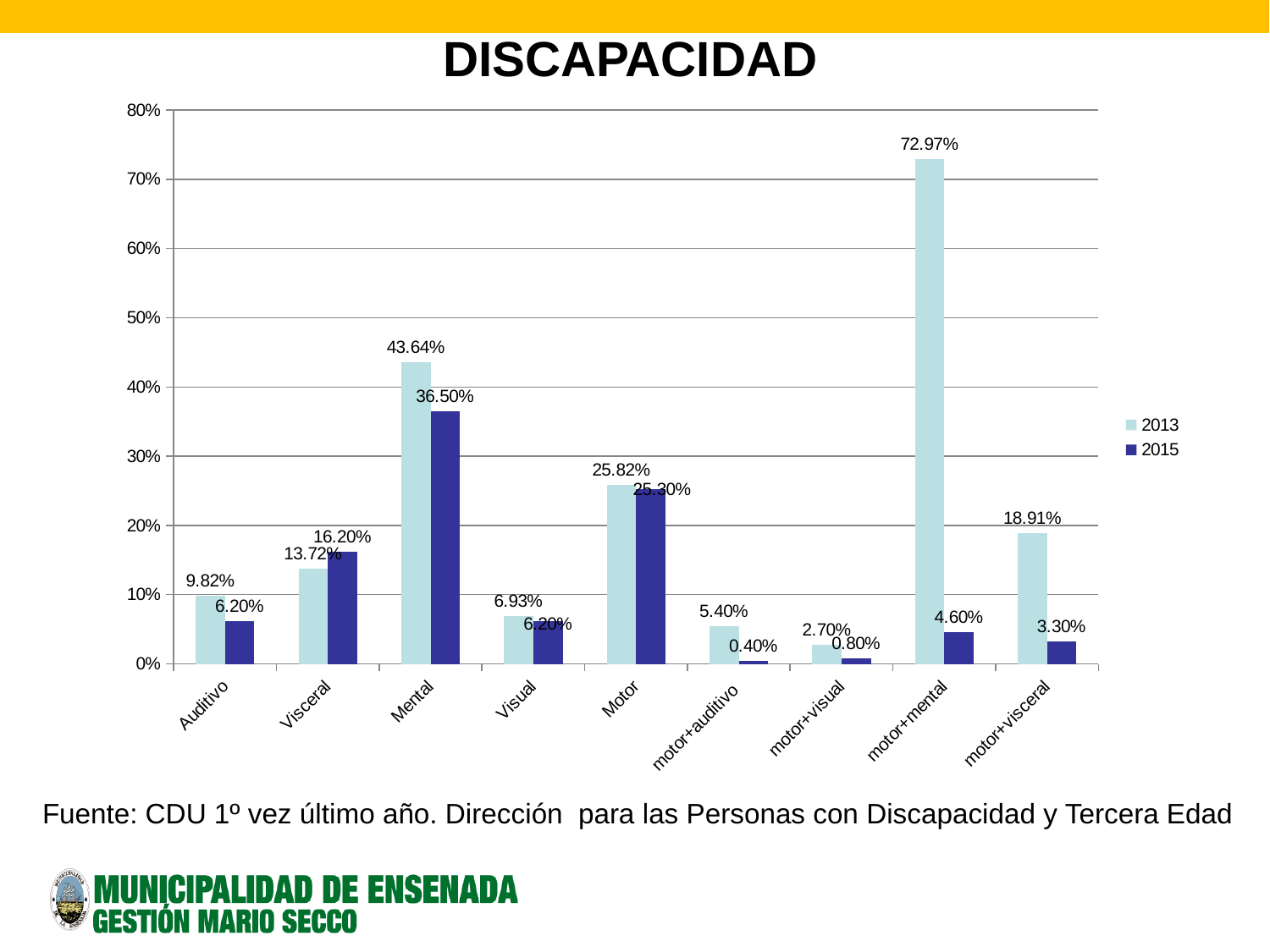
What is the 2013 value for Visceral? 13.72% Is the 2013 value for Mental greater or less than 40%? greater How many series does the legend list? 2 What is the 2015 value for Mental? 36.50% Which is larger for Visceral, the 2013 value or the 2015 value? 2015 What is the difference between the 2013 and 2015 values for motor+visceral? 15.61% What is the 2015 value for motor+auditivo? 0.40% What is the 2013 value for motor+mental? 72.97% Which category has the lowest 2015 value? motor+auditivo How many categories are shown on the x axis? 9 Which category has the highest 2013 value? motor+mental What type of chart is shown on the slide? bar chart